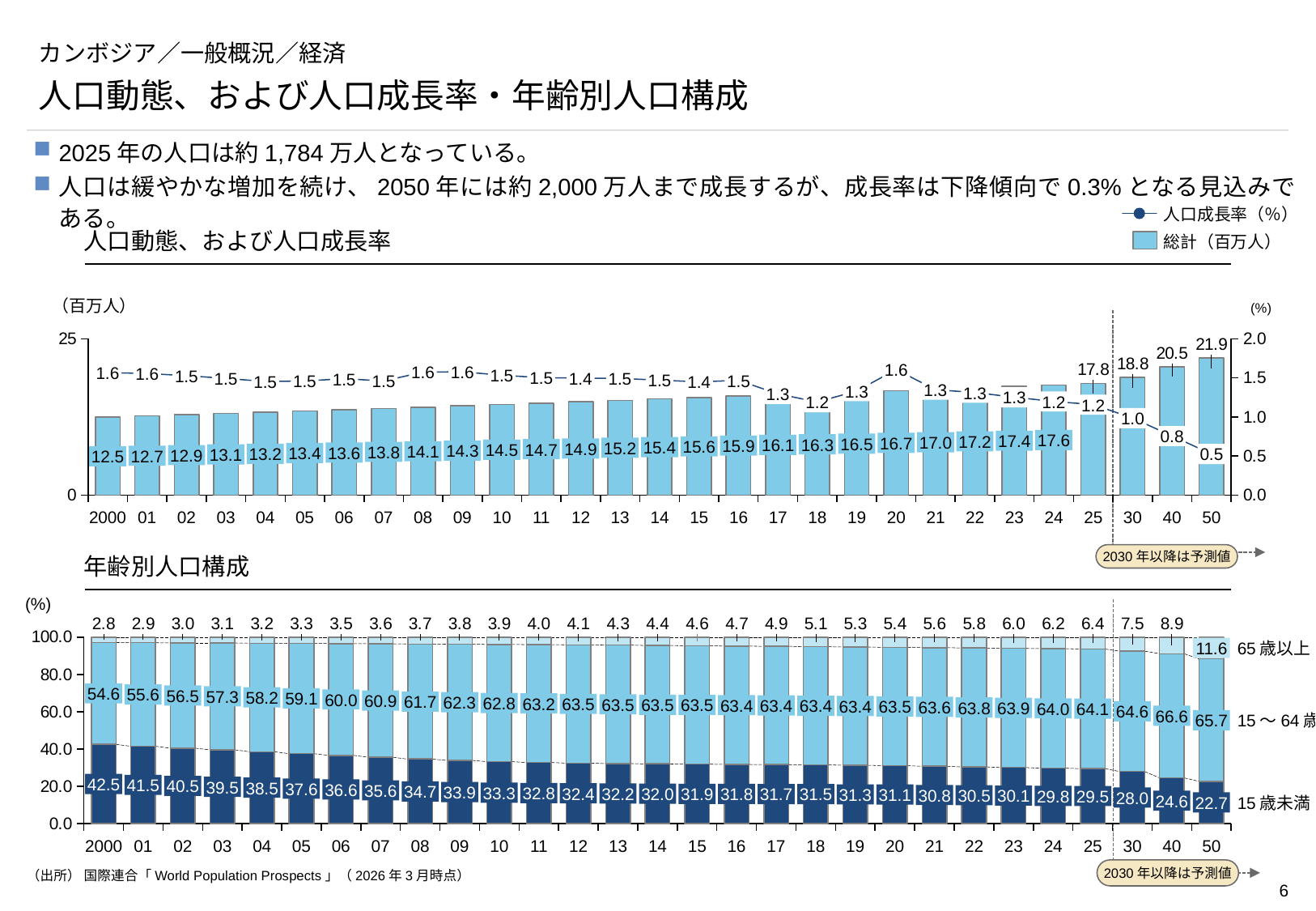
In the top chart (人口動態、および人口成長率), which year has the highest total population? 2050 How many series does the legend of the top chart (人口動態、および人口成長率) list? 2 In the bottom chart (年齢別人口構成), what is the difference between the share of 15歳未満 in 2000 and in 2050? 19.8 In the top chart (人口動態、および人口成長率), does the population growth rate rise or fall from 2025 to 2050? fall In the top chart (人口動態、および人口成長率), what is the total population (総計) for 2025? 17.8 In the top chart (人口動態、および人口成長率), what is the population growth rate (人口成長率) for 2050? 0.5 In the bottom chart (年齢別人口構成), which year has the larger share of 15～64歳: 2040 or 2050? 2040 In the bottom chart (年齢別人口構成), which year has the lowest share of 15歳未満? 2050 In the bottom chart (年齢別人口構成), what is the share of 15歳未満 in 2000? 42.5 In the bottom chart (年齢別人口構成), what is the share of 65歳以上 in 2050? 11.6 In the top chart (人口動態、および人口成長率), what is the difference between the total population in 2050 and in 2000? 9.4 What kind of chart is the top chart (人口動態、および人口成長率)? bar chart with a line